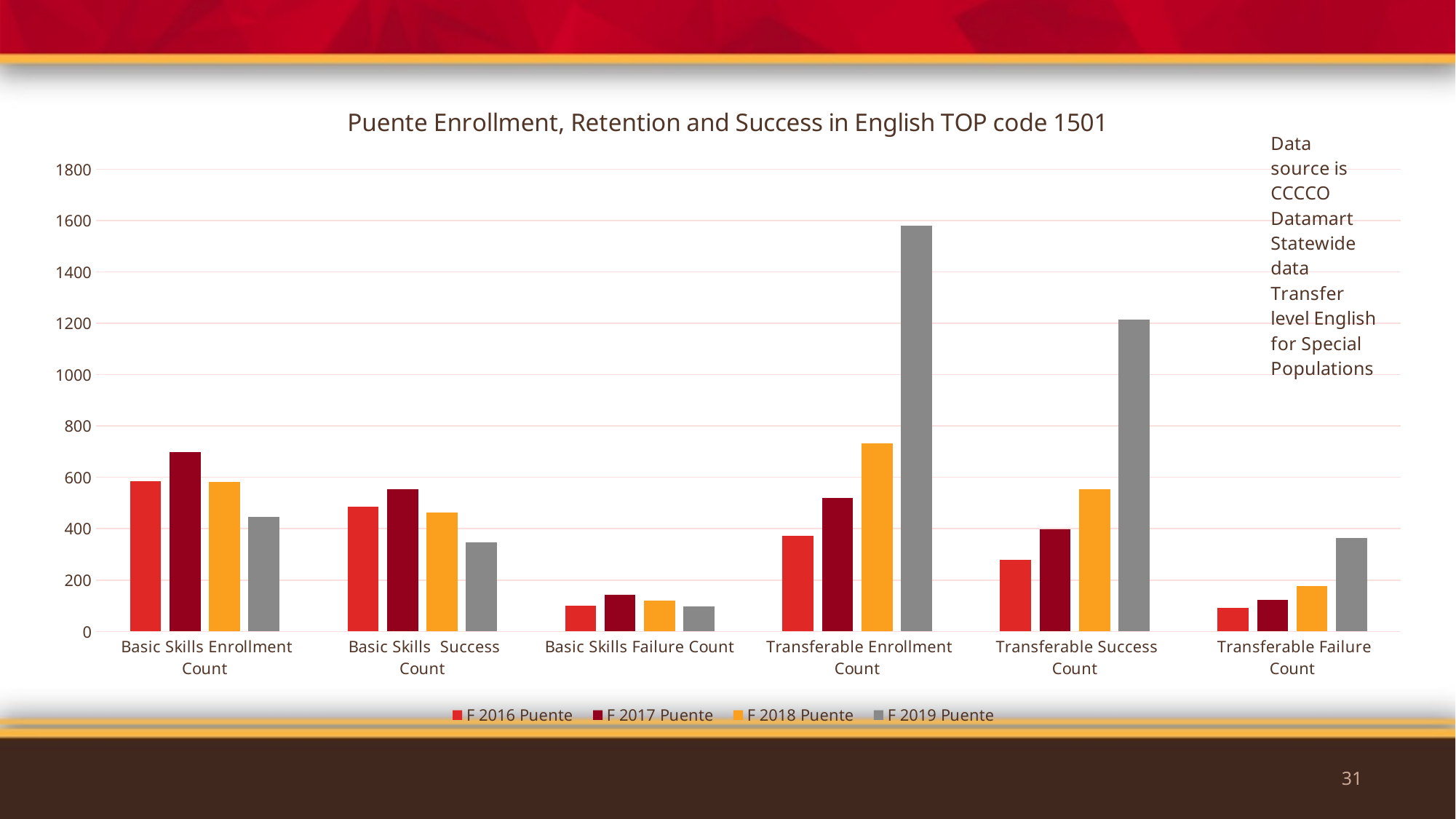
Within Transferable Enrollment Count, which series has the lowest value? F 2016 Puente How many series does the legend list? 4 What is the title of the chart? Puente Enrollment, Retention and Success in English TOP code 1501 Is the F 2019 Puente value for Transferable Success Count greater or less than 1000? greater For Transferable Enrollment Count, do the values rise or fall from F 2016 Puente to F 2019 Puente? rise For Basic Skills Enrollment Count, which is larger: the F 2017 Puente value or the F 2019 Puente value? F 2017 Puente Is the F 2016 Puente value for Basic Skills Failure Count greater or less than 200? less Is the F 2017 Puente value for Basic Skills Enrollment Count greater or less than 600? greater Which category has the highest F 2019 Puente bar? Transferable Enrollment Count What kind of chart is shown on the slide? bar chart How many categories are shown along the x axis? 6